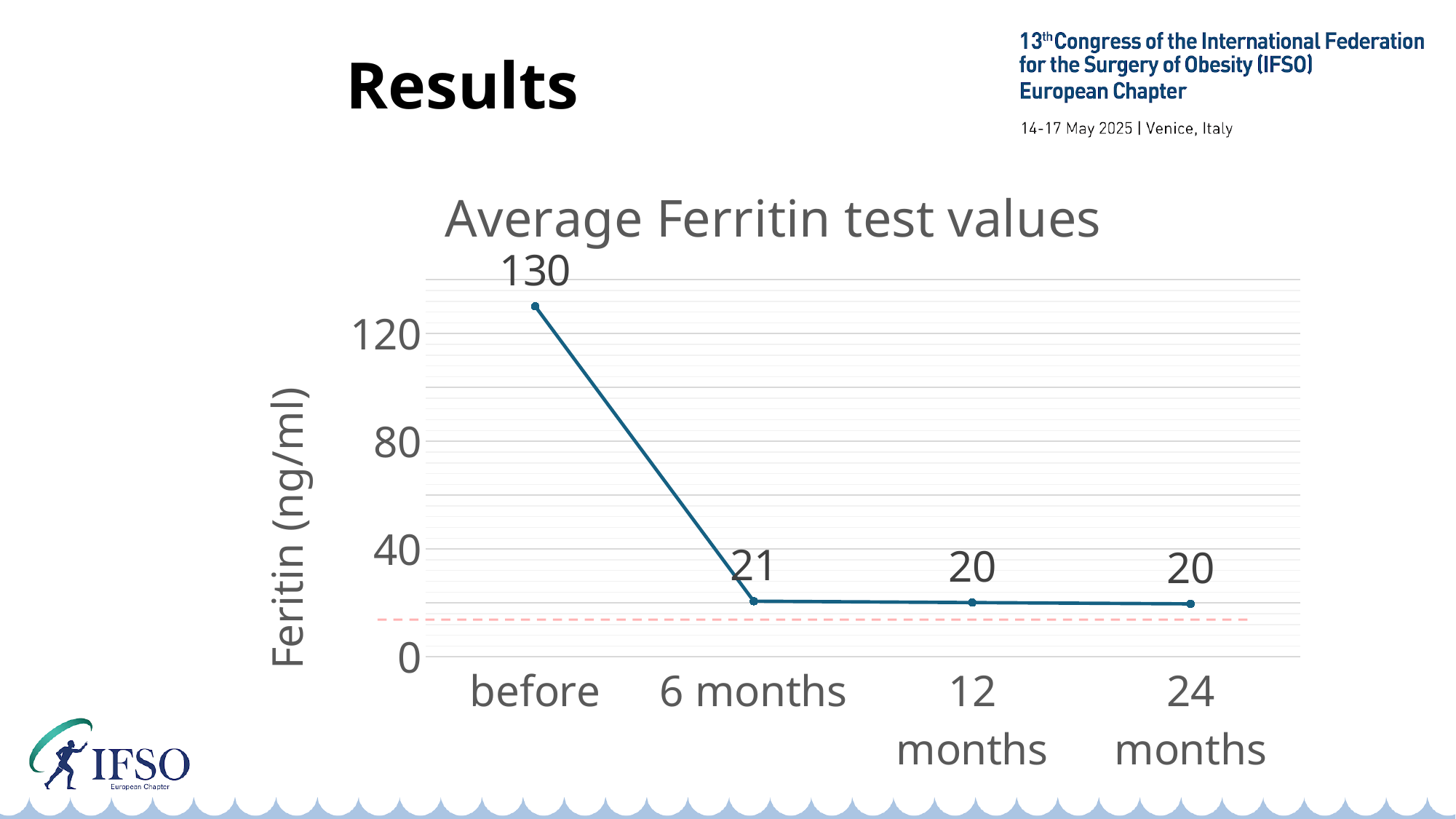
Is the ferritin value before surgery greater or less than 120? greater What is the average ferritin value at 12 months? 20 What kind of chart is shown on the slide? line chart At which time point is the average ferritin value highest? before What is the average ferritin value at 24 months? 20 What is the difference between the ferritin value at 6 months and at 12 months? 1 What is the average ferritin value before surgery? 130 How many time points are plotted on the chart? 4 What is the average ferritin value at 6 months? 21 Which is larger, the ferritin value before surgery or at 24 months? before What is the difference between the ferritin value before surgery and at 6 months? 109 What is the title of the chart? Average Ferritin test values